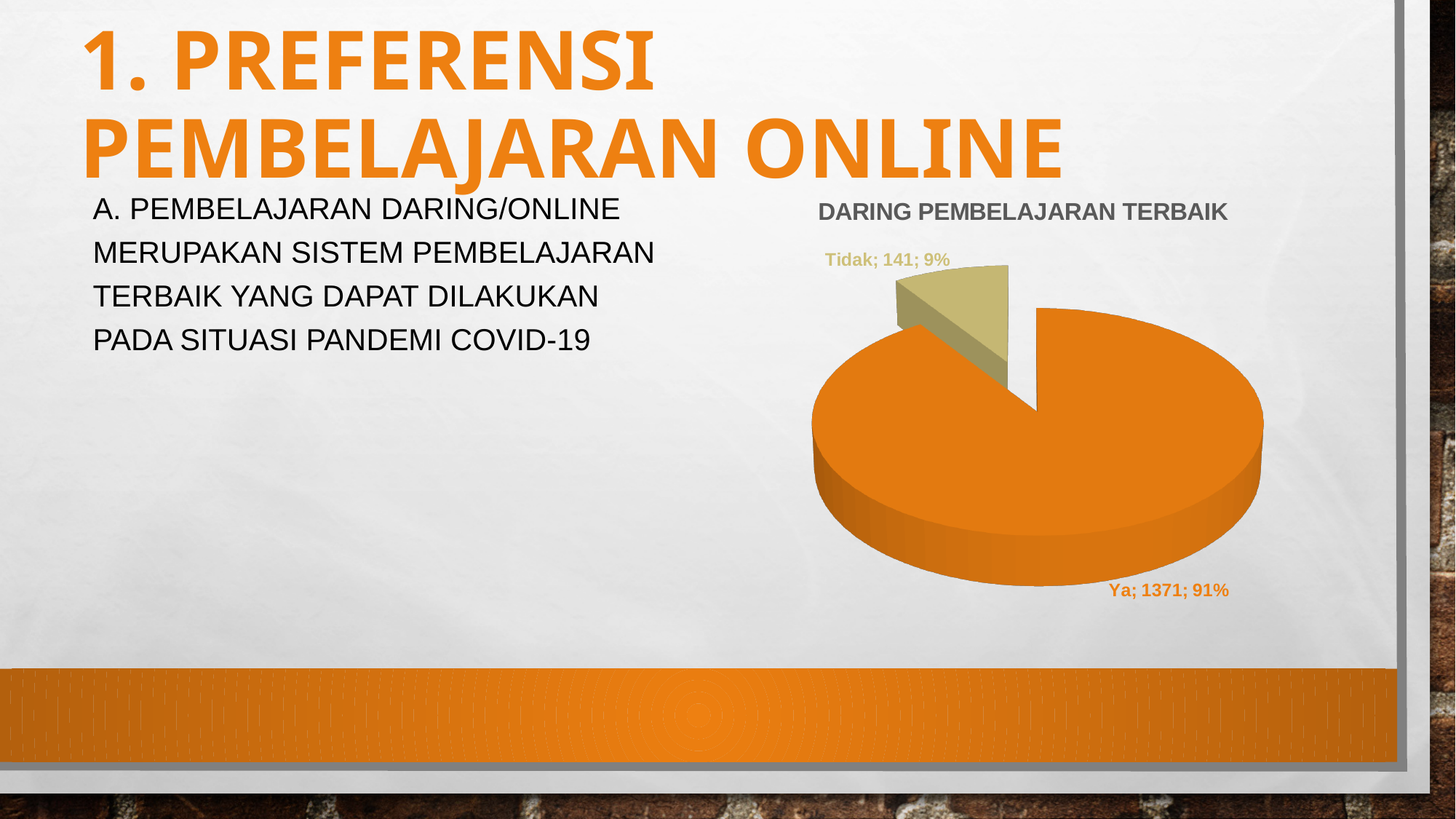
What share of the pie does the "Tidak" slice represent? 9% What is the difference between the "Ya" and "Tidak" values? 1230 What kind of chart is shown on the slide? pie chart What share of the pie does the "Ya" slice represent? 91% What is the value for the "Tidak" slice? 141 What is the total of the two slice values? 1512 How many slices does the pie chart have? 2 What is the title of the chart? DARING PEMBELAJARAN TERBAIK Which slice is the largest? Ya Which is larger, the value for "Ya" or the value for "Tidak"? Ya Which slice is the smallest? Tidak What is the value for the "Ya" slice? 1371